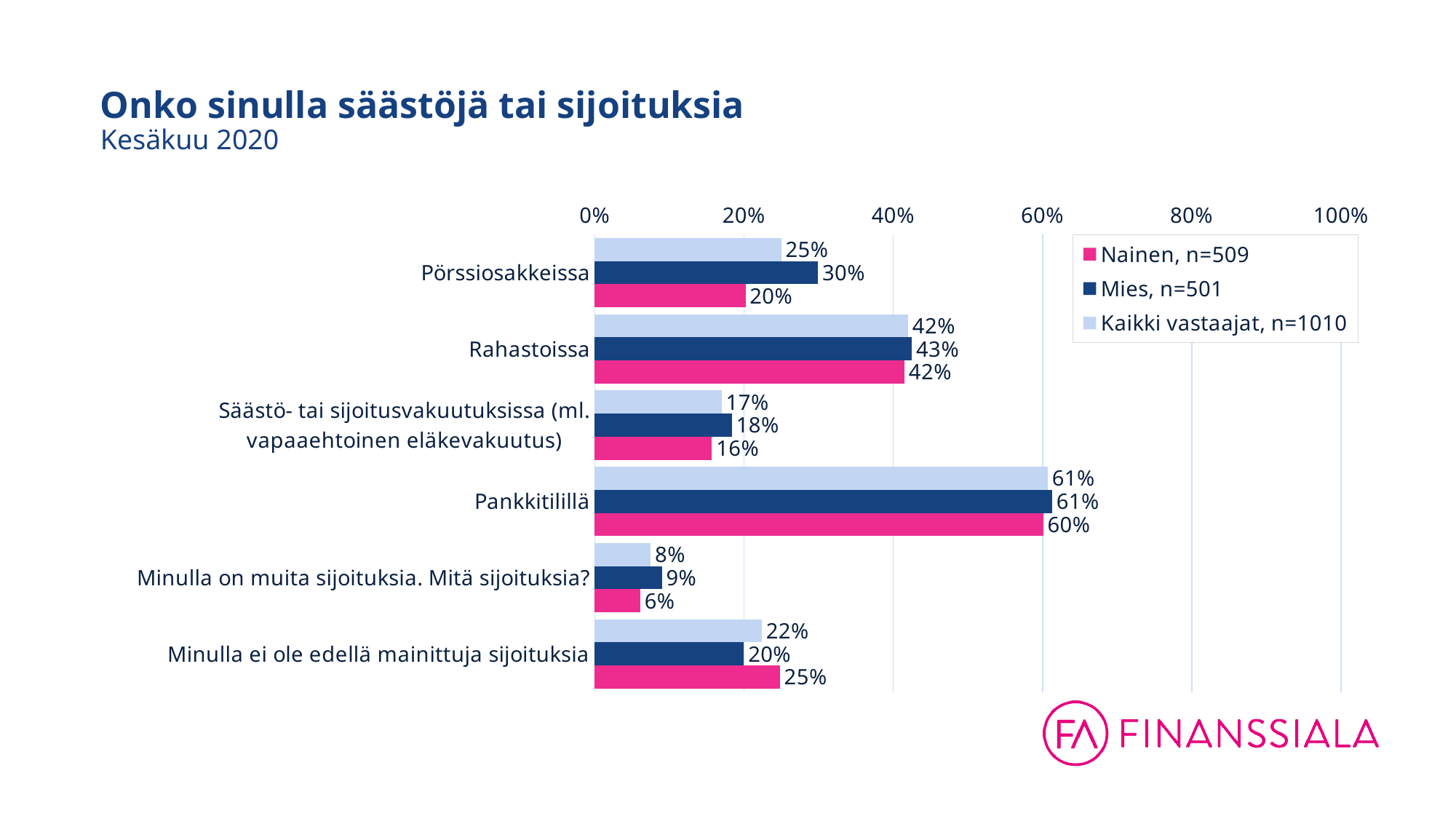
Which category has the highest value for Kaikki vastaajat, n=1010? Pankkitilillä Which category has the lowest value for Nainen, n=509? Minulla on muita sijoituksia. Mitä sijoituksia? What kind of chart is shown on the slide? Bar chart What percentage of Nainen, n=509 respondents have savings in Pörssiosakkeissa? 20% How many categories are shown on the y axis of the chart? 6 What is the value for Mies, n=501 in the Rahastoissa category? 43% What is the value for Kaikki vastaajat, n=1010 in the Pankkitilillä category? 61% Which is larger for Minulla ei ole edellä mainittuja sijoituksia: the Nainen, n=509 value or the Mies, n=501 value? Nainen, n=509 What is the difference between the Mies, n=501 and Nainen, n=509 values for Pörssiosakkeissa? 10% How many series does the legend list? 3 Is the Mies, n=501 value for Pankkitilillä greater or less than 40%? greater What colour represents the Nainen, n=509 series? Pink